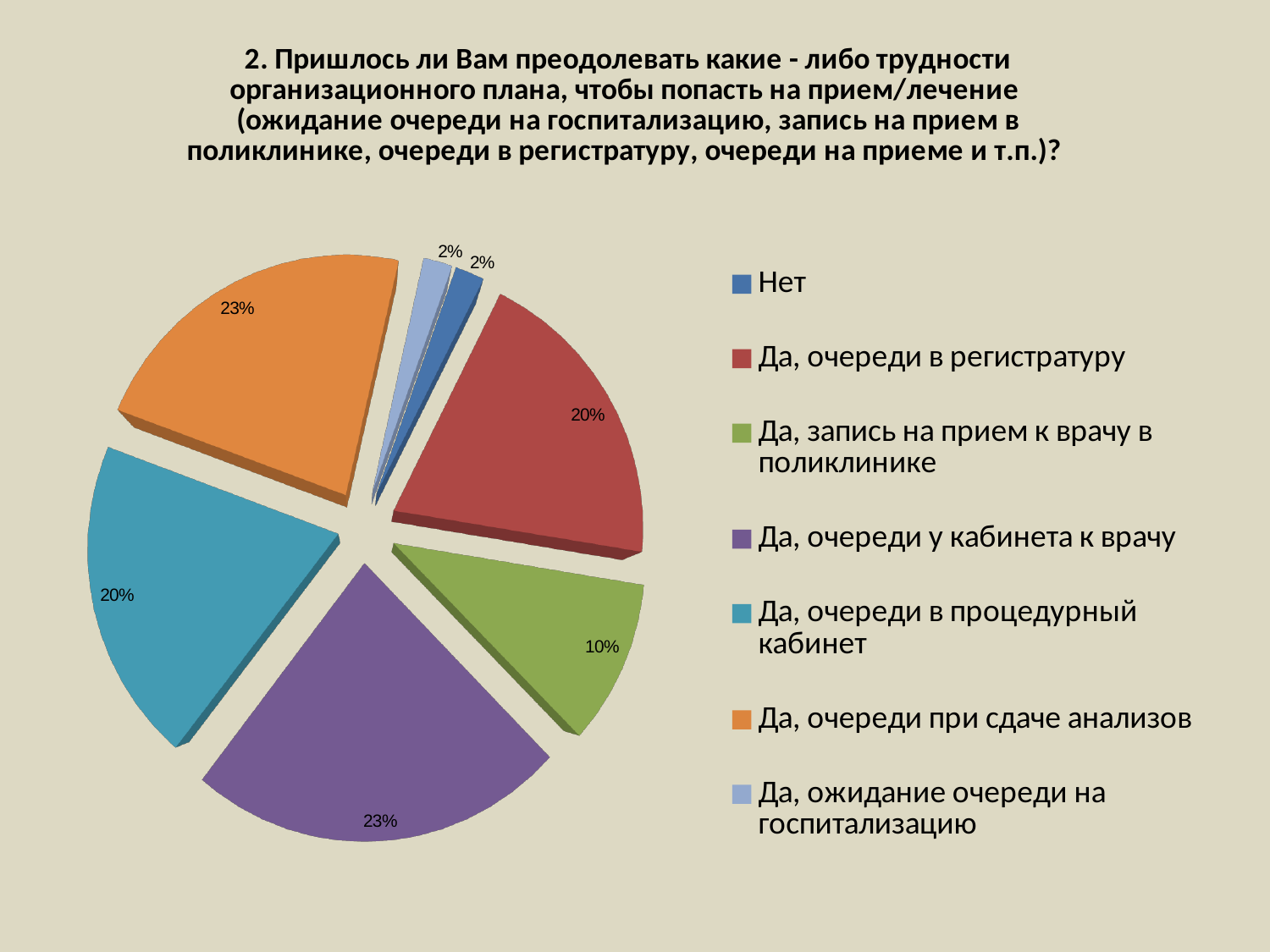
What share of the pie does "Да, очереди в регистратуру" take? 20% What share of the pie does "Да, очереди в процедурный кабинет" take? 20% What share of the pie does "Да, ожидание очереди на госпитализацию" take? 2% Which legend entry is shown in orange? Да, очереди при сдаче анализов How many slices does the pie chart have? 7 What kind of chart is shown on the slide? pie chart What is the difference in percentage points between the share for "Да, очереди при сдаче анализов" and the share for "Да, запись на прием к врачу в поликлинике"? 13 Which is larger: the share for "Да, очереди у кабинета к врачу" or the share for "Да, запись на прием к врачу в поликлинике"? Да, очереди у кабинета к врачу